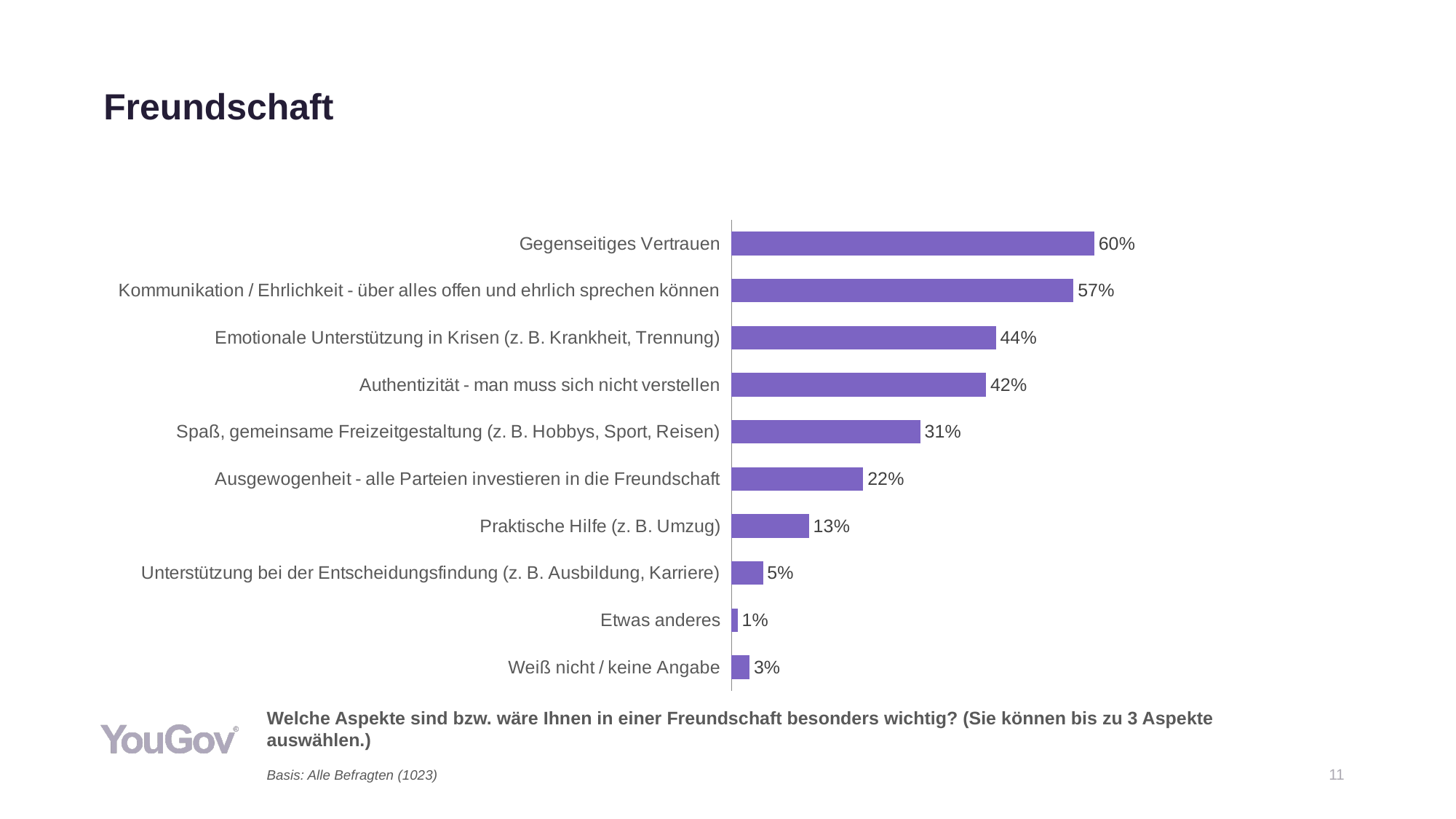
How many categories are shown in the chart? 10 What type of chart is shown on the slide? Bar chart What percentage is shown for "Praktische Hilfe (z. B. Umzug)"? 13% Which is larger: "Weiß nicht / keine Angabe" or "Etwas anderes"? Weiß nicht / keine Angabe What is the title of the slide? Freundschaft Which is larger: "Authentizität - man muss sich nicht verstellen" or "Spaß, gemeinsame Freizeitgestaltung (z. B. Hobbys, Sport, Reisen)"? Authentizität - man muss sich nicht verstellen Which category has the highest value? Gegenseitiges Vertrauen Which category has the lowest value? Etwas anderes What is the value for "Spaß, gemeinsame Freizeitgestaltung (z. B. Hobbys, Sport, Reisen)"? 31% What is the value for "Gegenseitiges Vertrauen"? 60% What is the difference between "Gegenseitiges Vertrauen" and "Kommunikation / Ehrlichkeit - über alles offen und ehrlich sprechen können"? 3 percentage points What is the difference between "Emotionale Unterstützung in Krisen (z. B. Krankheit, Trennung)" and "Ausgewogenheit - alle Parteien investieren in die Freundschaft"? 22 percentage points